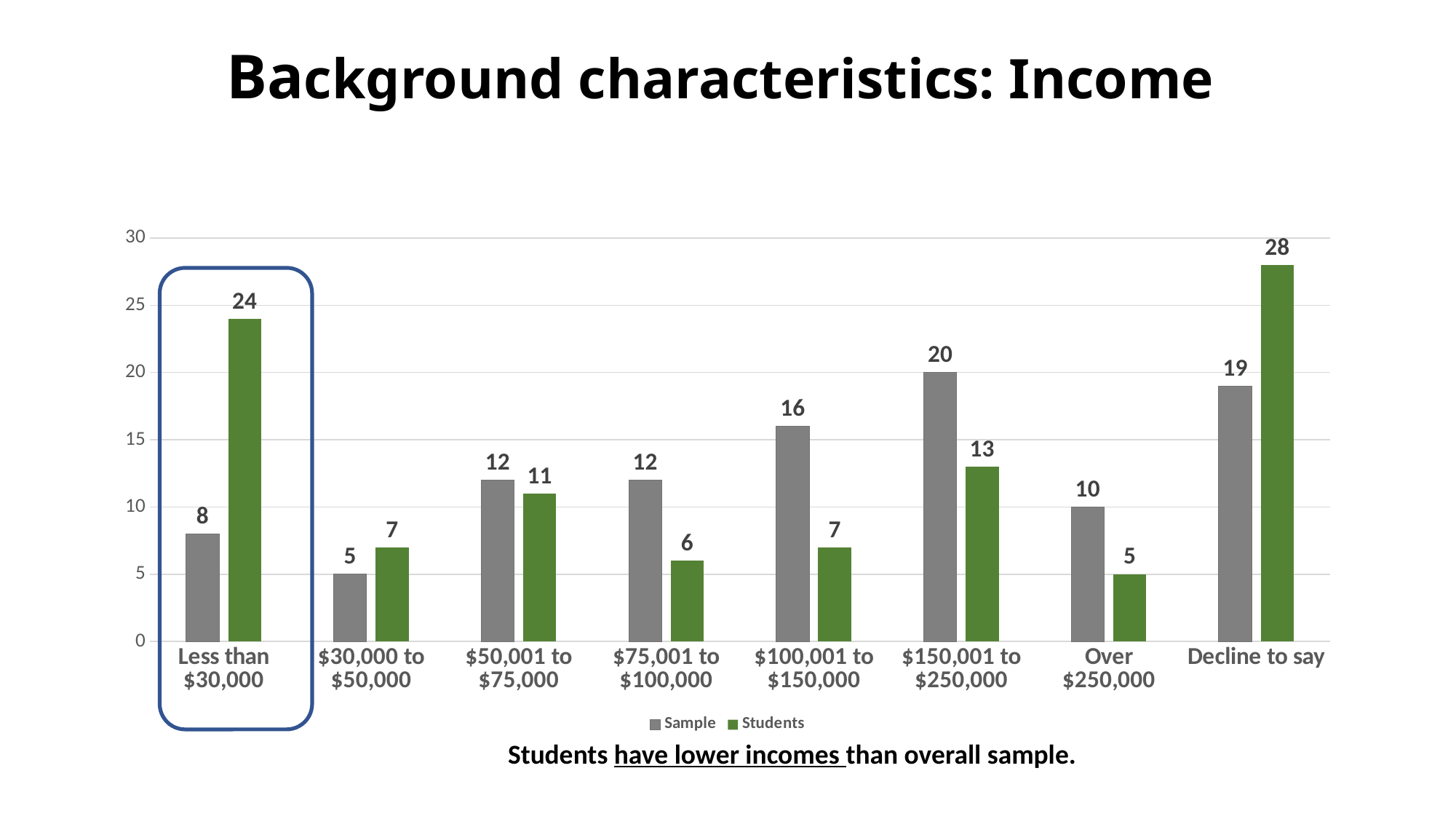
What is the difference between the Students and Sample values for Less than $30,000? 16 What kind of chart is shown on the slide? bar chart Which category has the highest Sample value? $150,001 to $250,000 What is the Students value for the Less than $30,000 category? 24 Which category has the lowest Students value? Over $250,000 What colour are the Students bars? green How many income categories are shown on the x axis? 8 What is the Students value for Decline to say? 28 How many series does the legend list? 2 What is the Sample value for the $150,001 to $250,000 category? 20 Which is larger for the $100,001 to $150,000 category, Sample or Students? Sample Is the Students value for Decline to say greater or less than 25? greater